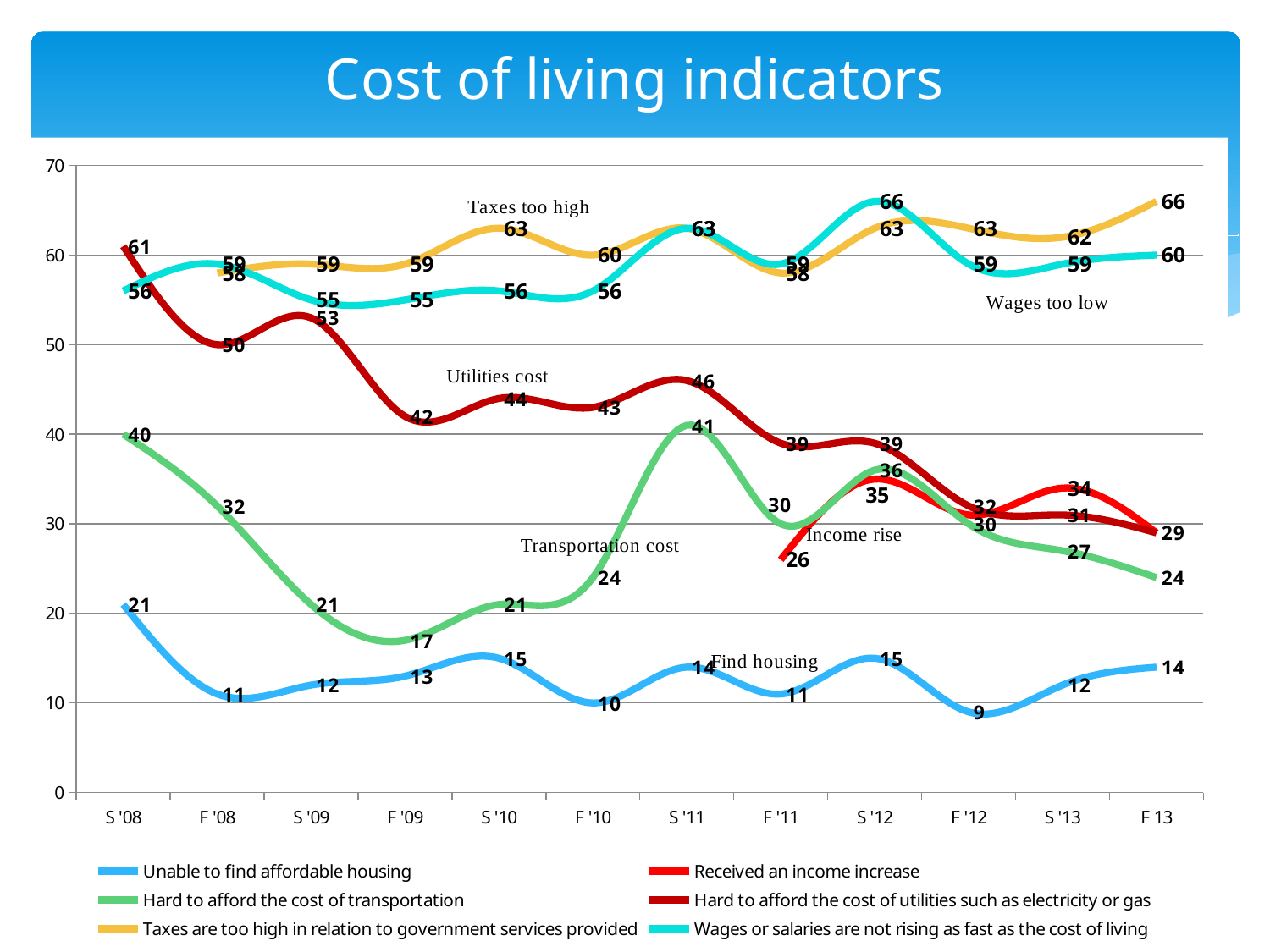
What kind of chart is shown on the slide? line chart What is the value for 'Received an income increase' at F '11? 26 What is the difference between the 'Hard to afford the cost of utilities' value at S '08 and at F 13? 32 What is the value for 'Hard to afford the cost of utilities such as electricity or gas' at S '08? 61 At which time point does 'Hard to afford the cost of transportation' reach its highest value? S '11 How many series does the legend list? 6 How many time points are shown along the x axis? 12 At S '12, which is higher: 'Wages or salaries are not rising as fast as the cost of living' or 'Taxes are too high in relation to government services provided'? Wages or salaries are not rising as fast as the cost of living Does the 'Hard to afford the cost of utilities such as electricity or gas' line overall rise or fall from S '08 to F 13? fall What is the value for 'Taxes are too high in relation to government services provided' at F 13? 66 At which time point is 'Unable to find affordable housing' at its lowest value? F '12 What is the value for 'Unable to find affordable housing' at F '12? 9